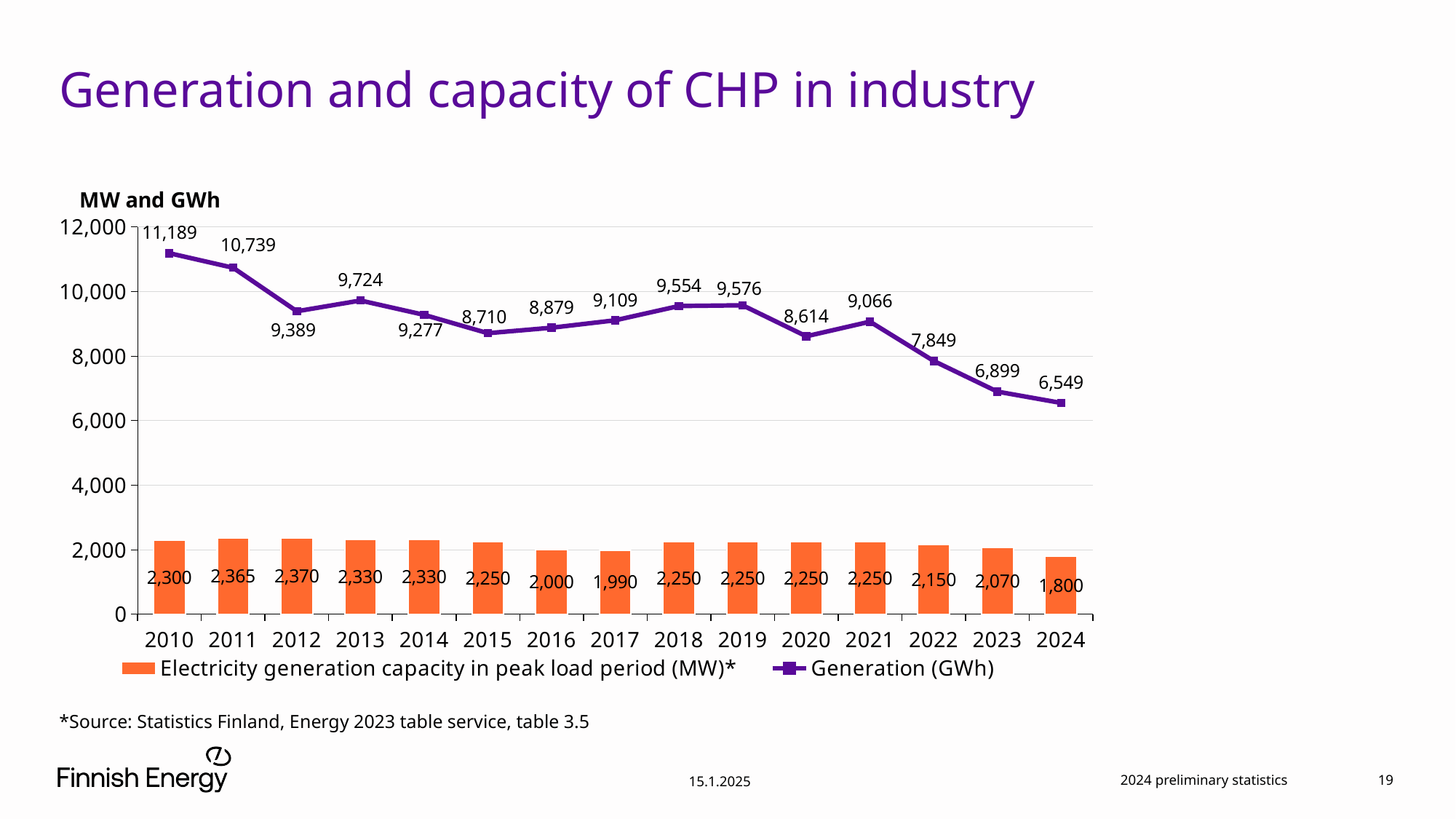
What colour are the bars for Electricity generation capacity in peak load period (MW)? Orange In which year was Generation (GWh) lowest? 2024 How many series does the legend list? 2 What was the Generation (GWh) value in 2019? 9,576 Which year had higher Generation (GWh), 2018 or 2020? 2018 What was the Generation (GWh) value in 2010? 11,189 In which year was the Electricity generation capacity in peak load period (MW) highest? 2012 In which year was Generation (GWh) highest? 2010 What is the overall trend of Generation (GWh) from 2019 to 2024? Falling What was the Electricity generation capacity in peak load period (MW) in 2024? 1,800 How many years are shown on the x axis? 15 What is the difference between Generation (GWh) in 2010 and in 2024? 4,640